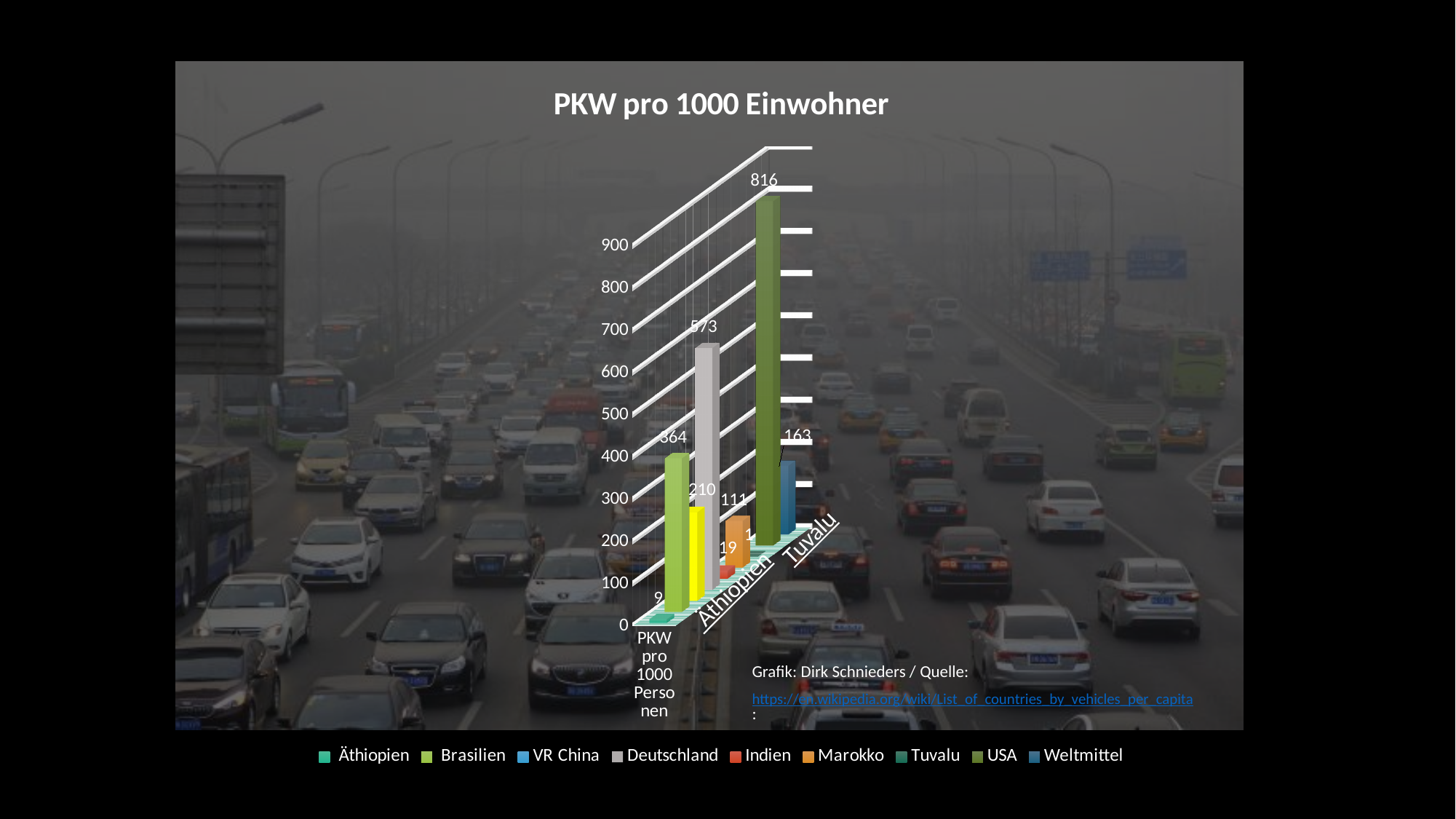
What is the difference between the values for USA and Deutschland? 243 Which country has the highest value? USA What is the title of the chart? PKW pro 1000 Einwohner What is the value for VR China? 210 What kind of chart is shown on the slide? bar chart What is the value for Marokko? 111 Which is larger, the value for Brasilien or the value for VR China? Brasilien What is the value for Brasilien? 364 What is the value for Deutschland? 573 What is the value for USA? 816 How many series does the legend list? 9 What is the value for Weltmittel? 163